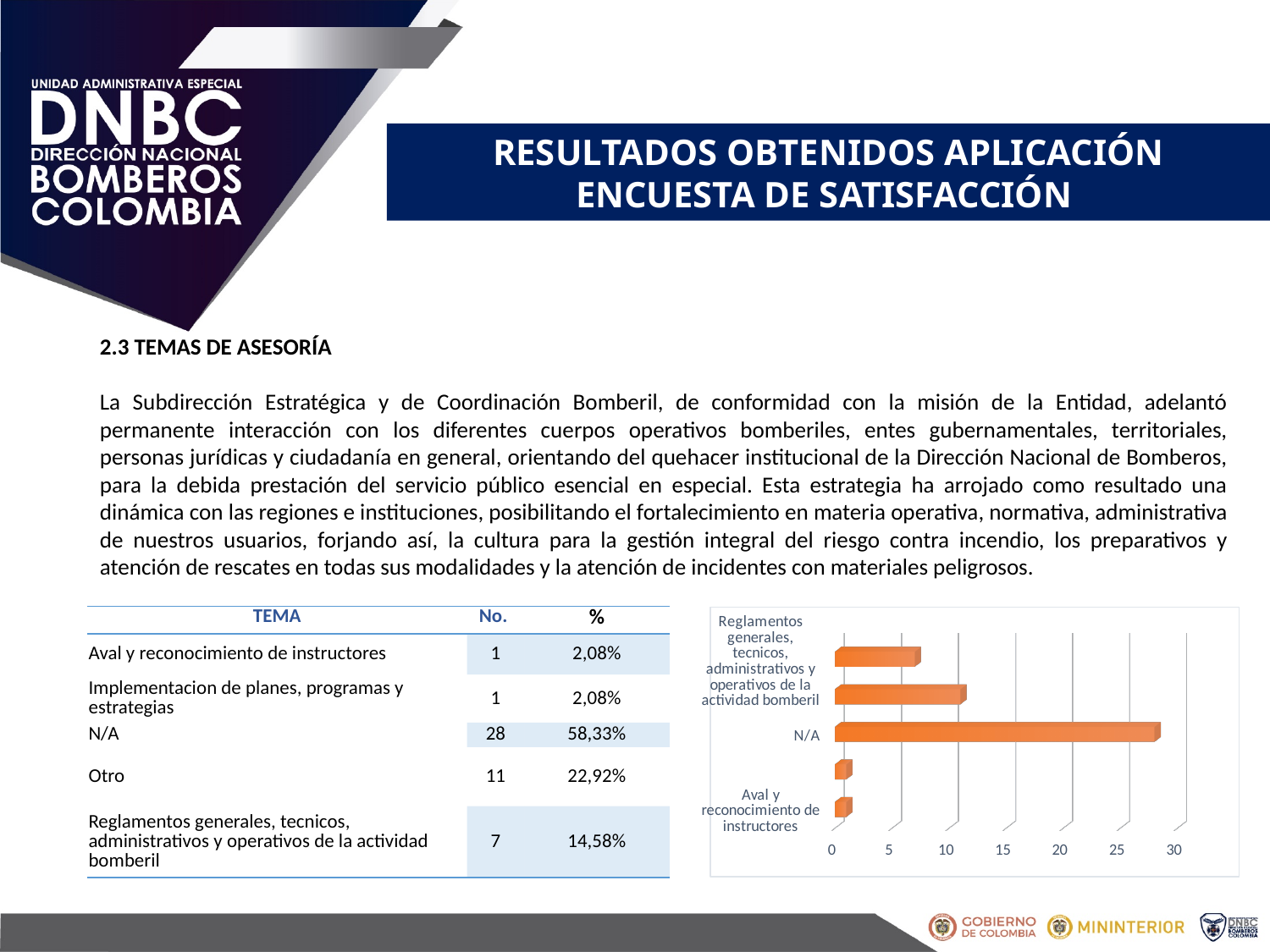
Which category has the longest bar in the chart? N/A Is the value for N/A in the chart greater or less than 25? greater Is the value for Aval y reconocimiento de instructores in the chart greater or less than 5? less What is the interval between tick marks on the chart's horizontal axis? 5 In the chart, which is larger: the bar for N/A or the bar for Aval y reconocimiento de instructores? N/A In the chart, which is larger: the bar for N/A or the bar for Reglamentos generales, tecnicos, administrativos y operativos de la actividad bomberil? N/A What is the highest tick value shown on the chart's horizontal axis? 30 What kind of chart is shown on the slide? bar chart Is the value for Reglamentos generales, tecnicos, administrativos y operativos de la actividad bomberil in the chart greater or less than 10? less How many bars are plotted in the chart? 5